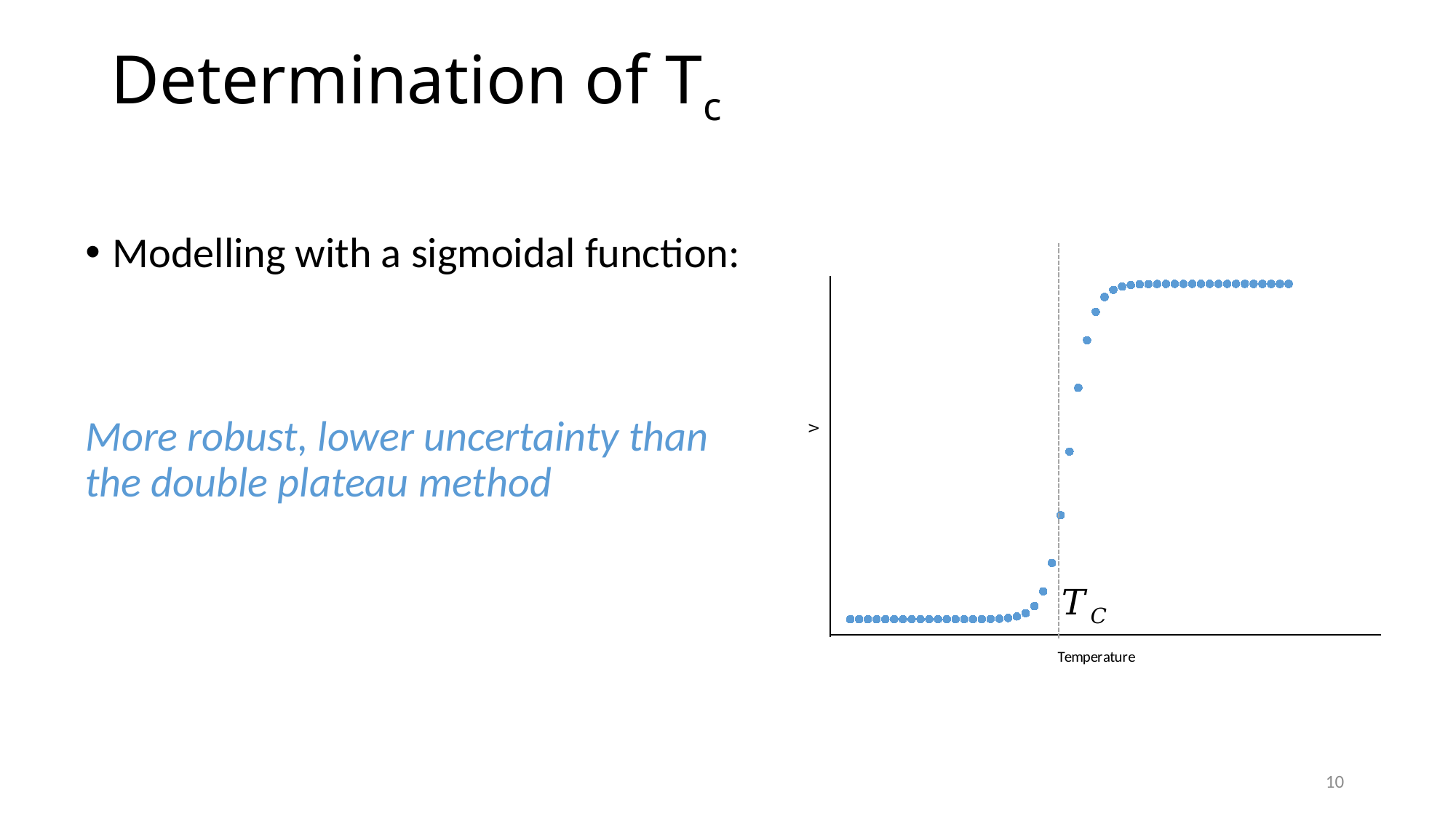
Is the value of V at the far right of the chart higher or lower than at the far left? higher What kind of chart is shown on the right of the slide? scatter chart Do the plotted values rise or fall as temperature increases along the x axis? rise What does the dashed vertical line on the chart mark? T_C What shape does the plotted curve follow according to the slide text? sigmoidal What is the label on the y axis of the chart? V What is the label on the x axis of the chart? Temperature